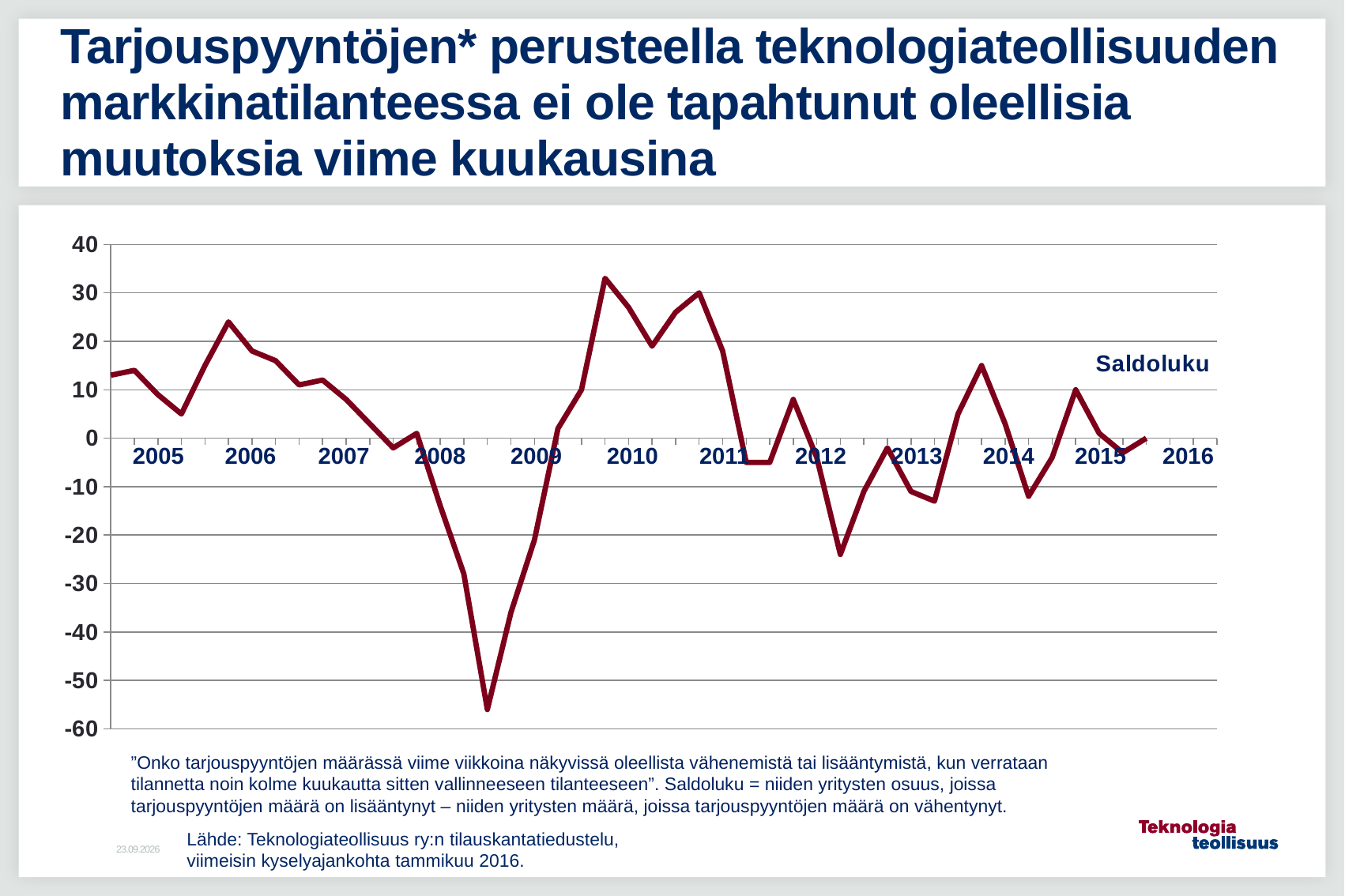
Is the highest value reached by the line greater or less than 30? greater How many series does the chart plot? 1 Which is larger, the value at 2006 or the value at 2008? 2006 How many year labels are shown on the x axis? 12 Is the value at 2006 greater or less than 10? greater Is the value at 2013 greater or less than 0? less What kind of chart is shown on the slide? line chart Between 2010 and 2012, does the line generally rise or fall? fall What is the name of the series shown on the chart? Saldoluku